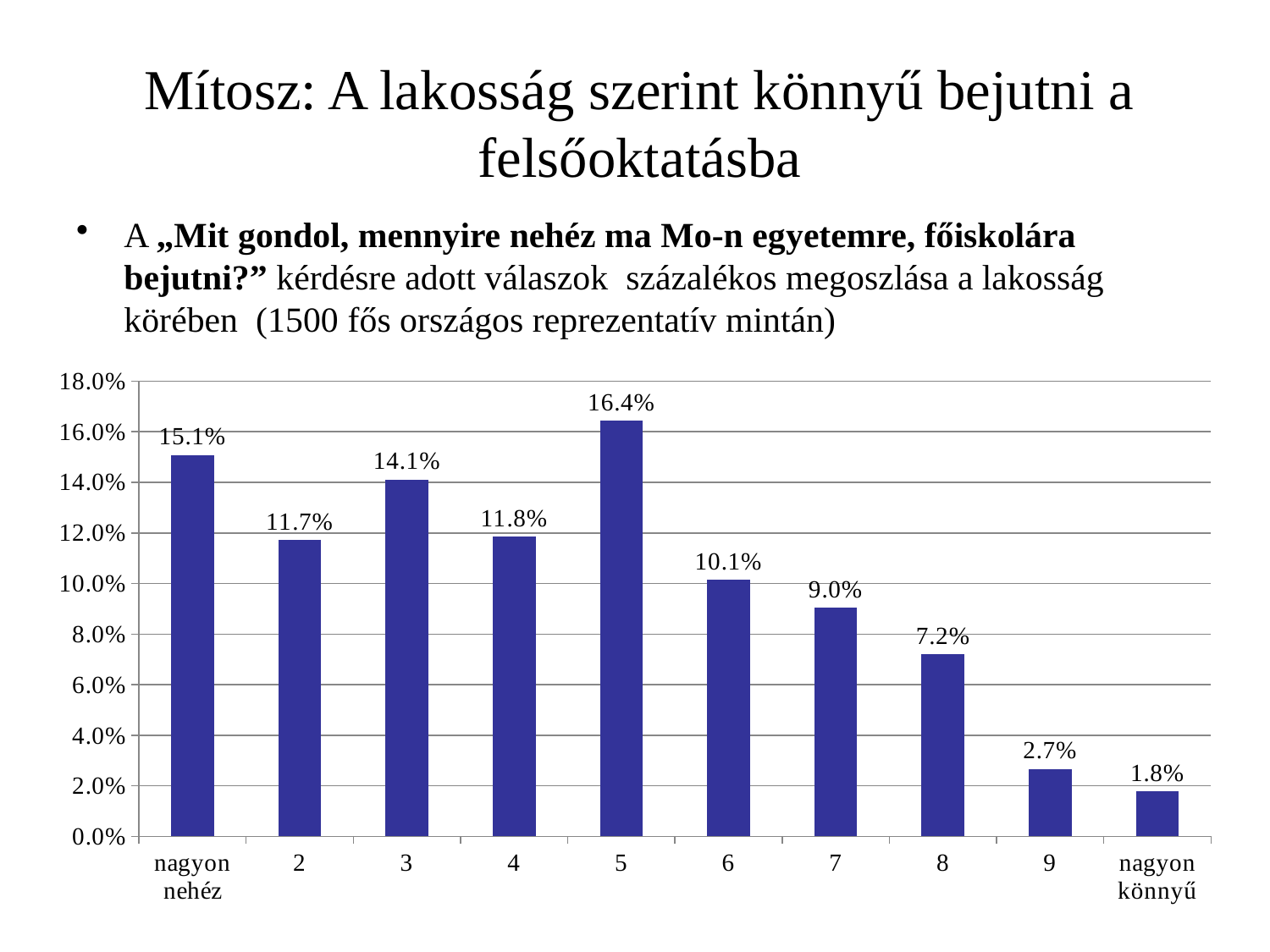
How many categories are shown on the x axis? 10 What is the value for category 8? 7.2% What is the value for category 5? 16.4% What is the difference between the values for category 5 and category 6? 6.3% What is the value for the category "nagyon nehéz"? 15.1% Which is larger, the value for category 3 or the value for category 4? 3 What kind of chart is shown on the slide? bar chart Which category has the highest value? 5 Which category has the lowest value? nagyon könnyű Is the value for category 7 greater or less than 10.0%? less What is the value for the category "nagyon könnyű"? 1.8% Do the values generally rise or fall from category 5 to "nagyon könnyű"? fall